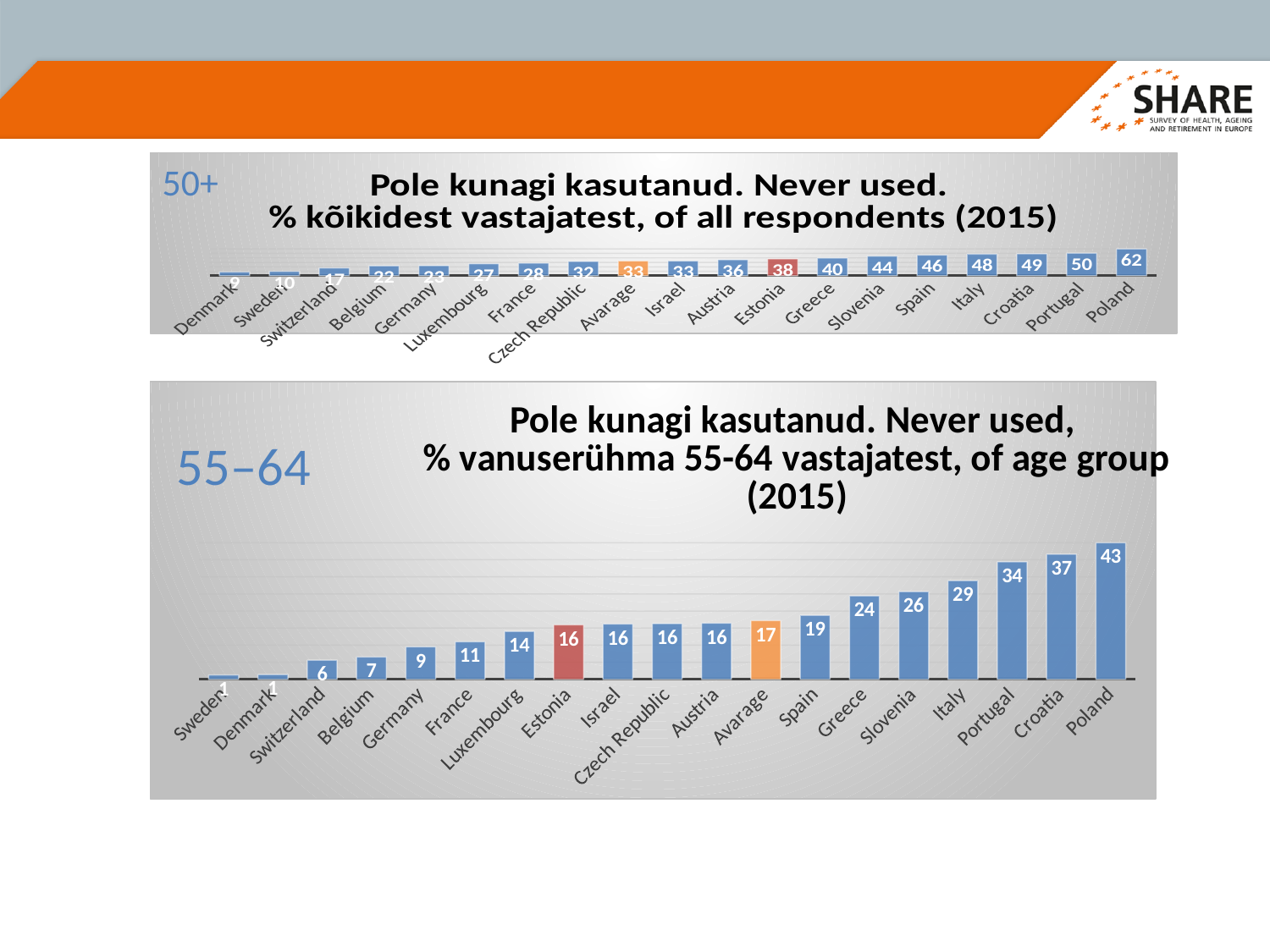
In the bottom chart (55–64 age group), do the values rise or fall from left to right? Rise In the top chart (50+), which country has the highest value? Poland In the top chart (50+), what is the value for Estonia? 38 In the bottom chart (55–64 age group), what is the value for Poland? 43 In the bottom chart (55–64 age group), how many bars are plotted? 19 In the top chart (50+), what is the value for Poland? 62 In the bottom chart (55–64 age group), what is the difference between Poland and Croatia? 6 In the bottom chart (55–64 age group), what is the value for Estonia? 16 In the bottom chart (55–64 age group), what is the value for Avarage? 17 In the bottom chart (55–64 age group), which country has the highest value? Poland In the top chart (50+), which is larger, the value for Spain or the value for Greece? Spain What type of chart is the bottom chart (55–64 age group)? Bar chart